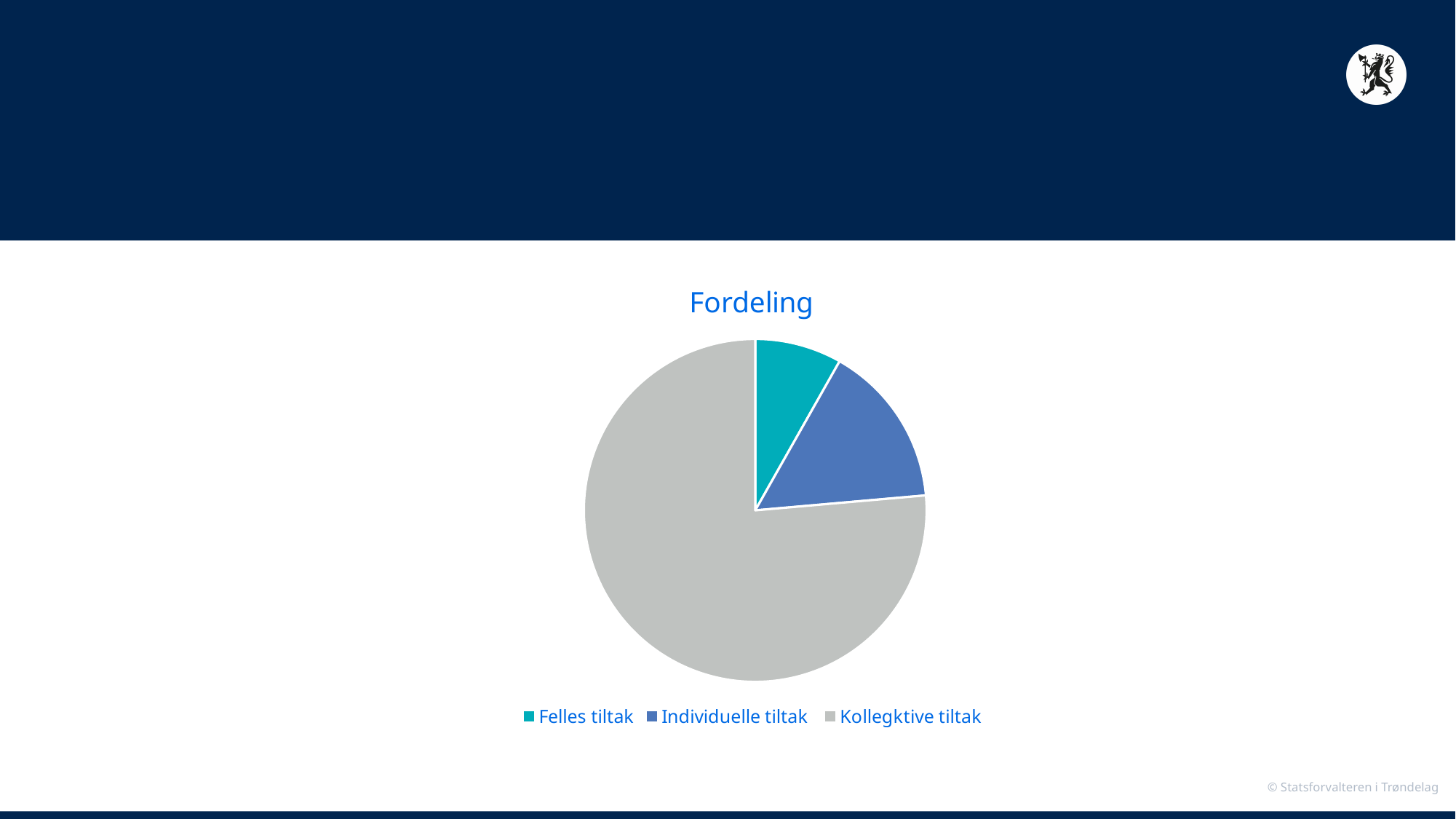
Does Kollegktive tiltak account for more or less than half of the pie? more How many entries does the legend list? 3 What kind of chart is shown on the slide? pie chart Which slice is larger, Kollegktive tiltak or Individuelle tiltak? Kollegktive tiltak How many slices does the pie chart have? 3 What colour is the Kollegktive tiltak slice? grey Which category has the largest slice of the pie? Kollegktive tiltak What is the title of the chart? Fordeling Which slice is larger, Individuelle tiltak or Felles tiltak? Individuelle tiltak Which category has the smallest slice of the pie? Felles tiltak